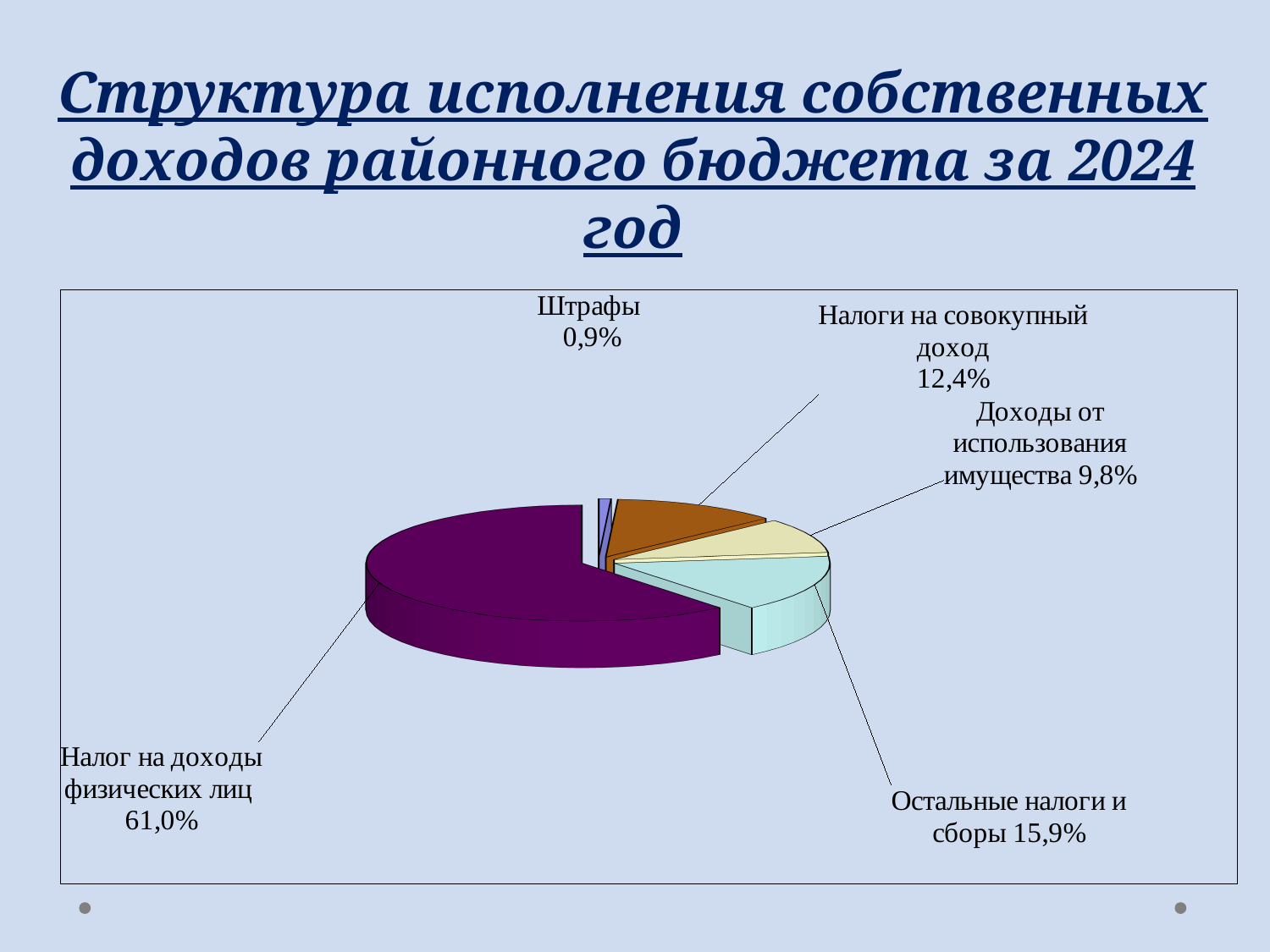
What share of the pie does "Штрафы" have? 0,9% What share of the pie does "Остальные налоги и сборы" have? 15,9% What share of the pie does "Доходы от использования имущества" have? 9,8% How many slices does the pie chart have? 5 Which category has the smallest slice of the pie? Штрафы What is the title of the slide containing the chart? Структура исполнения собственных доходов районного бюджета за 2024 год What is the difference in percentage points between "Налог на доходы физических лиц" and "Остальные налоги и сборы"? 45,1 What kind of chart is shown on the slide? Pie chart Which is larger: the share for "Остальные налоги и сборы" or for "Налоги на совокупный доход"? Остальные налоги и сборы Which category has the largest slice of the pie? Налог на доходы физических лиц